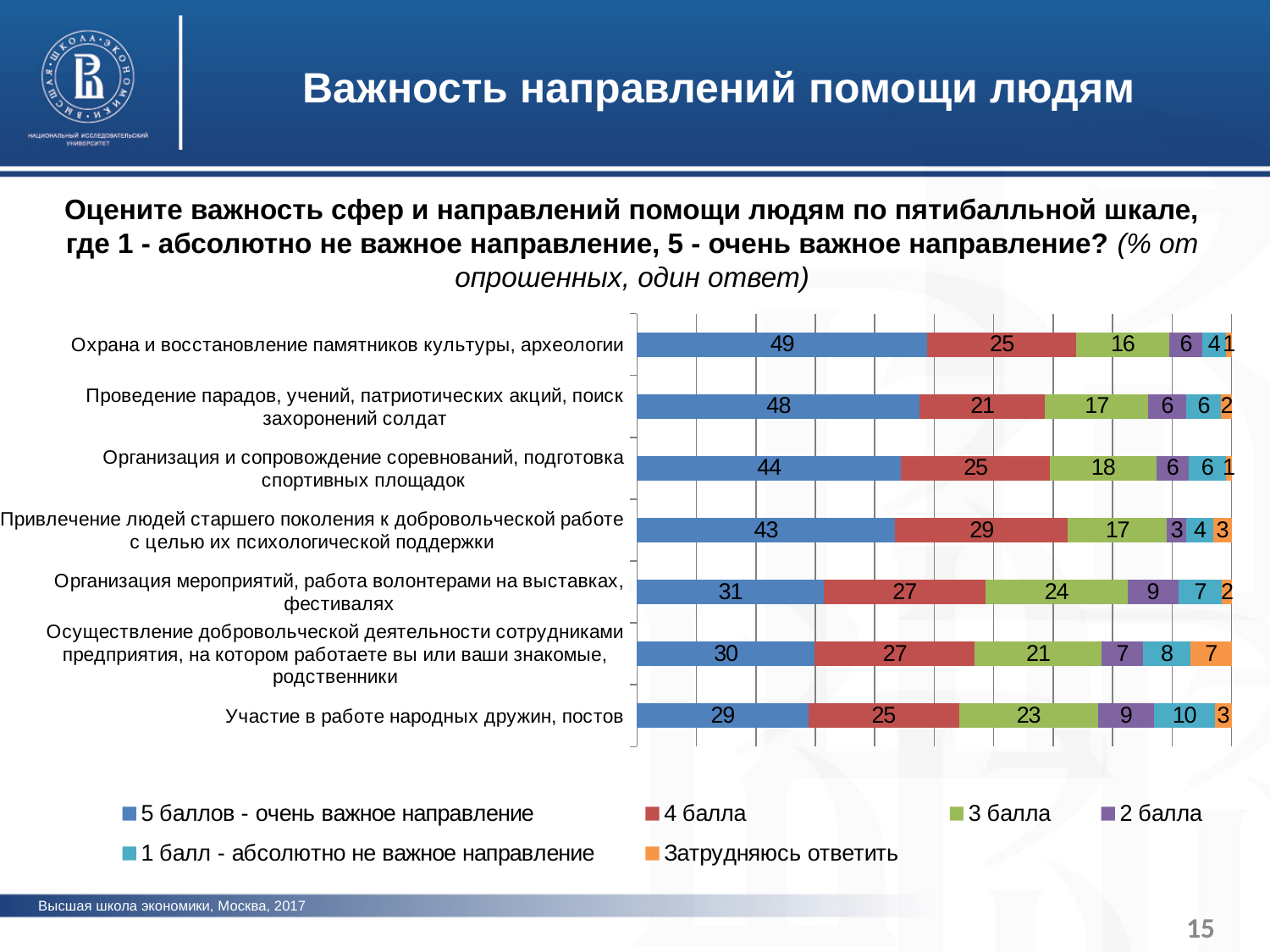
Which category has the lowest share of «5 баллов - очень важное направление»? Участие в работе народных дружин, постов What percentage rated «Охрана и восстановление памятников культуры, археологии» as 5 баллов - очень важное направление? 49 Which has a larger «3 балла» value: «Организация мероприятий, работа волонтерами на выставках, фестивалях» or «Проведение парадов, учений, патриотических акций, поиск захоронений солдат»? Организация мероприятий, работа волонтерами на выставках, фестивалях What is the value of «1 балл - абсолютно не важное направление» for «Участие в работе народных дружин, постов»? 10 What type of chart is shown on the slide? Stacked bar chart Which category has the highest share of «5 баллов - очень важное направление»? Охрана и восстановление памятников культуры, археологии How many categories (directions of help) are shown in the chart? 7 What is the total of the stacked bar for «Организация мероприятий, работа волонтерами на выставках, фестивалях»? 100 How many series does the legend list? 6 What is the value of «4 балла» for «Привлечение людей старшего поколения к добровольческой работе с целью их психологической поддержки»? 29 What is the value of «Затрудняюсь ответить» for «Осуществление добровольческой деятельности сотрудниками предприятия, на котором работаете вы или ваши знакомые, родственники»? 7 What is the difference between the «5 баллов - очень важное направление» values for «Охрана и восстановление памятников культуры, археологии» and «Участие в работе народных дружин, постов»? 20